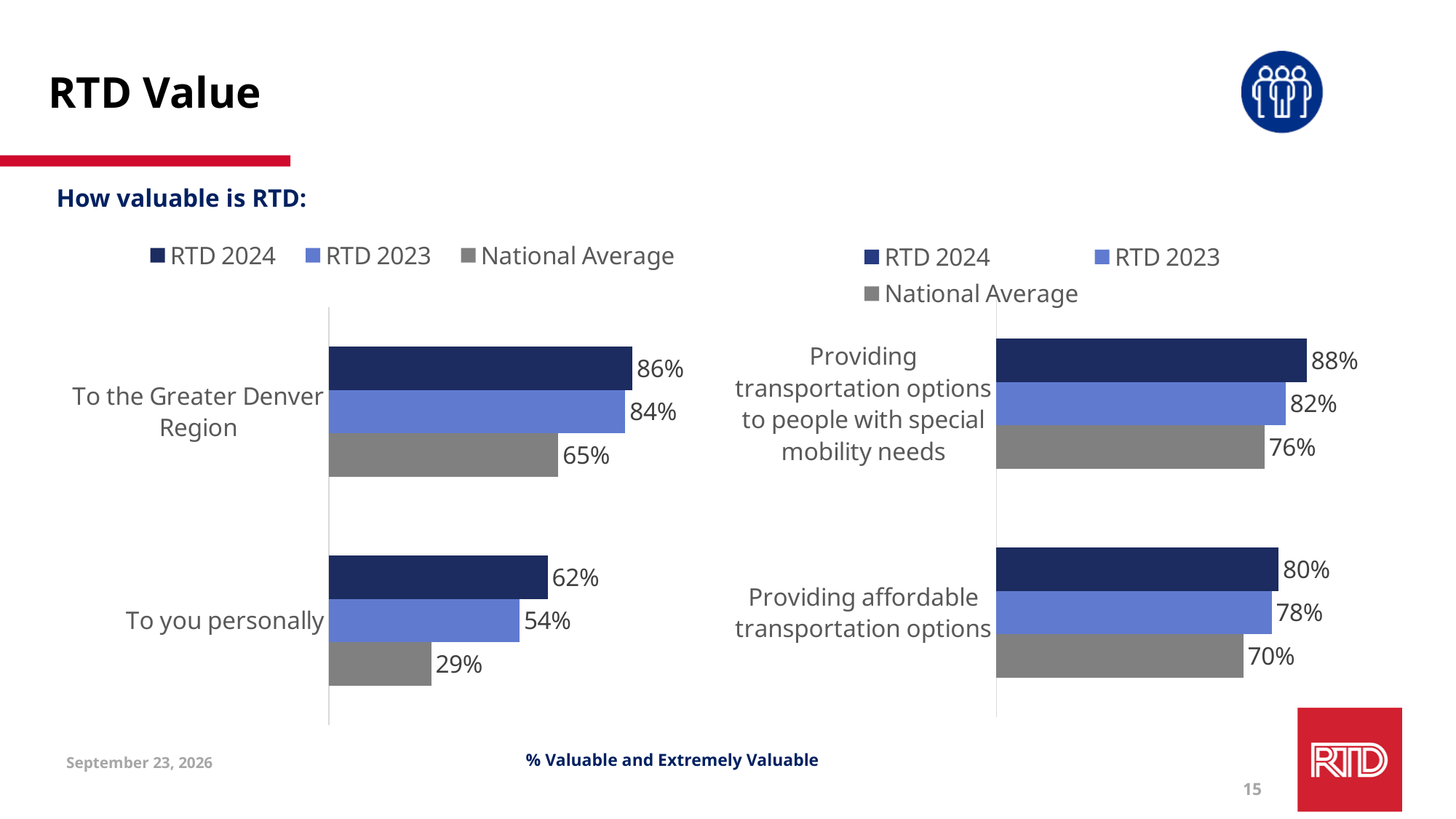
What type of chart is the left chart? Bar chart In the left chart, what is the difference between the RTD 2024 and RTD 2023 values for 'To you personally'? 8% In the right chart, which category has the highest RTD 2024 value? Providing transportation options to people with special mobility needs In the left chart, what is the RTD 2024 value for 'To the Greater Denver Region'? 86% In the right chart, what is the RTD 2023 value for 'Providing transportation options to people with special mobility needs'? 82% In the left chart, which is larger for 'To the Greater Denver Region': the RTD 2023 value or the National Average value? RTD 2023 How many categories are shown in the left chart? 2 How many series does the legend of the right chart list? 3 In the right chart, what is the National Average value for 'Providing affordable transportation options'? 70% In the left chart, which series has the lowest value for 'To you personally'? National Average In the right chart, what is the difference between the RTD 2024 and National Average values for 'Providing transportation options to people with special mobility needs'? 12% In the left chart, what is the National Average value for 'To you personally'? 29%